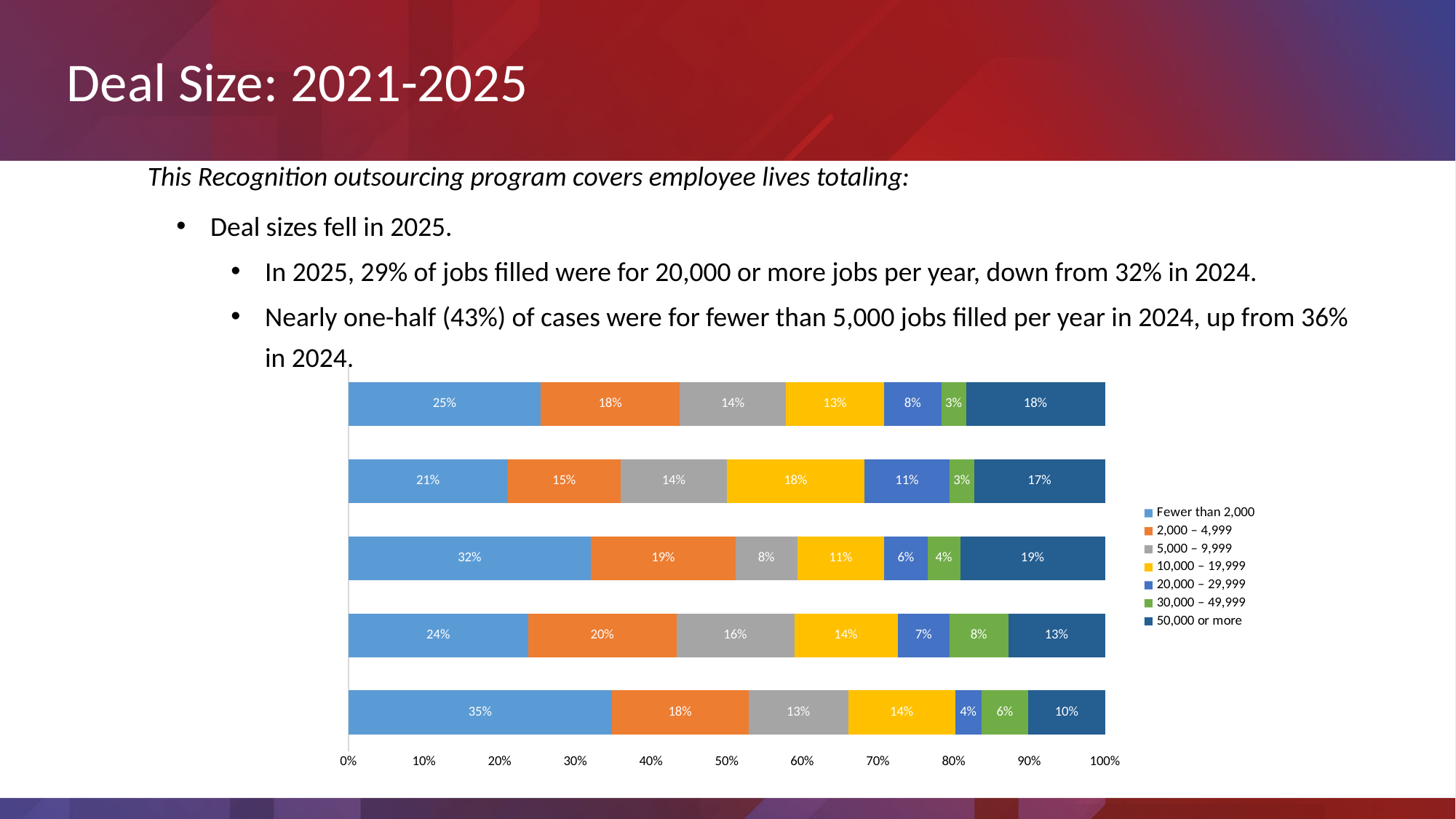
In the fourth bar from the top, which is larger: the '20,000 – 29,999' segment or the '30,000 – 49,999' segment? 30,000 – 49,999 In the bottom bar of the chart, what is the value for the 'Fewer than 2,000' segment? 35% Which bar has the smallest '50,000 or more' segment? The bottom bar (10%) In the second bar from the top, what is the value for the '10,000 – 19,999' segment? 18% In the top bar of the chart, what is the value for the '50,000 or more' segment? 18% How many stacked bars are plotted in the chart? 5 What colour represents the '10,000 – 19,999' series in the chart? Yellow What kind of chart is shown on the slide? Stacked bar chart Which bar has the largest 'Fewer than 2,000' segment? The bottom bar (35%) How many series does the chart's legend list? 7 In the third bar from the top, how much larger is the 'Fewer than 2,000' segment than the '5,000 – 9,999' segment? 24 percentage points In the fourth bar from the top, what is the value for the '5,000 – 9,999' segment? 16%